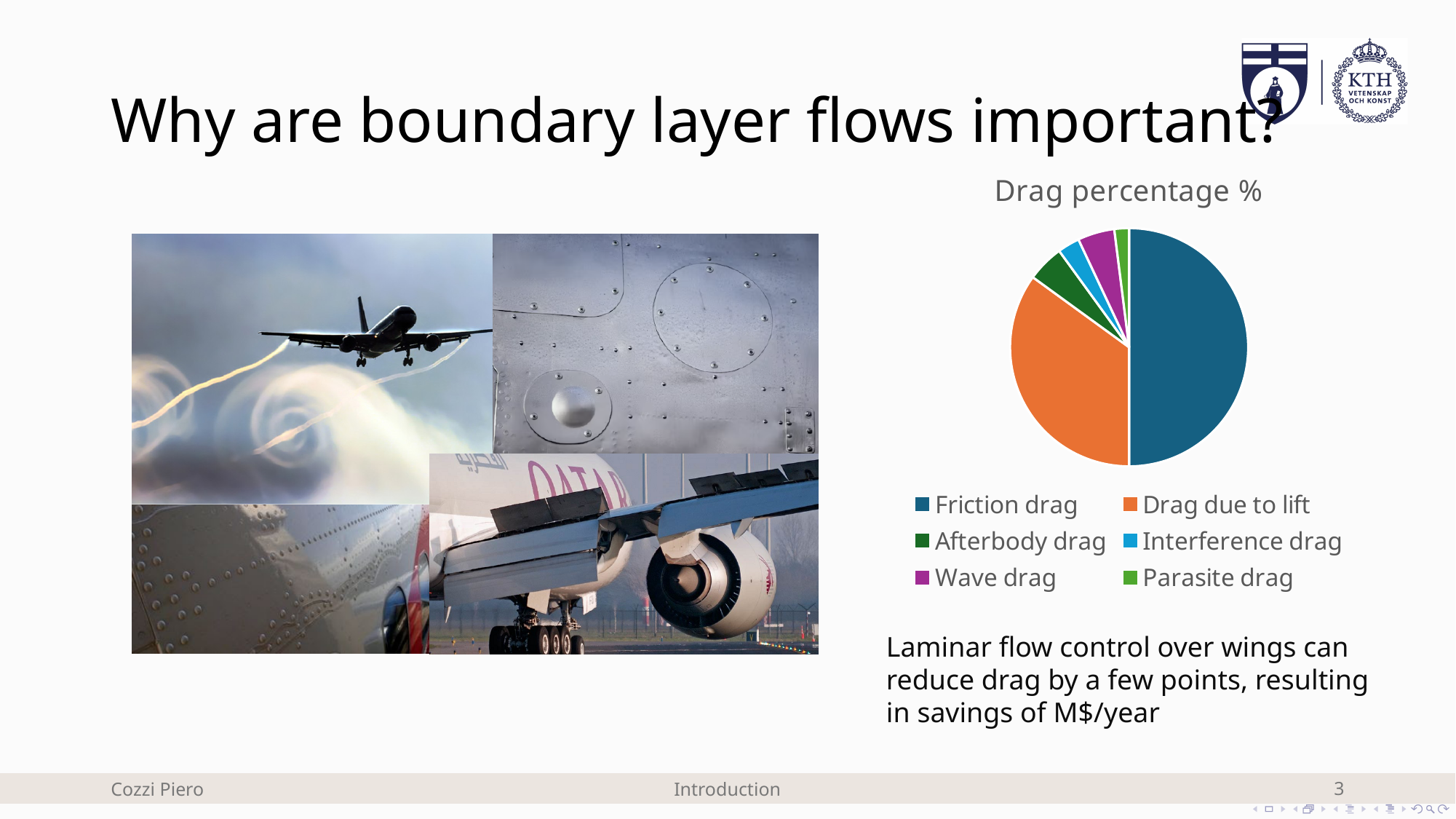
Which category has the largest slice of the pie? Friction drag Which category has the smallest slice of the pie? Parasite drag What is the title of the chart? Drag percentage % How many categories does the pie chart have? 6 Which category is the second largest slice of the pie? Drag due to lift Which is larger, Friction drag or Drag due to lift? Friction drag What kind of chart is shown on the slide? pie chart Which is larger, Drag due to lift or Afterbody drag? Drag due to lift Which is larger, Wave drag or Interference drag? Wave drag What colour is the slice for Drag due to lift? orange